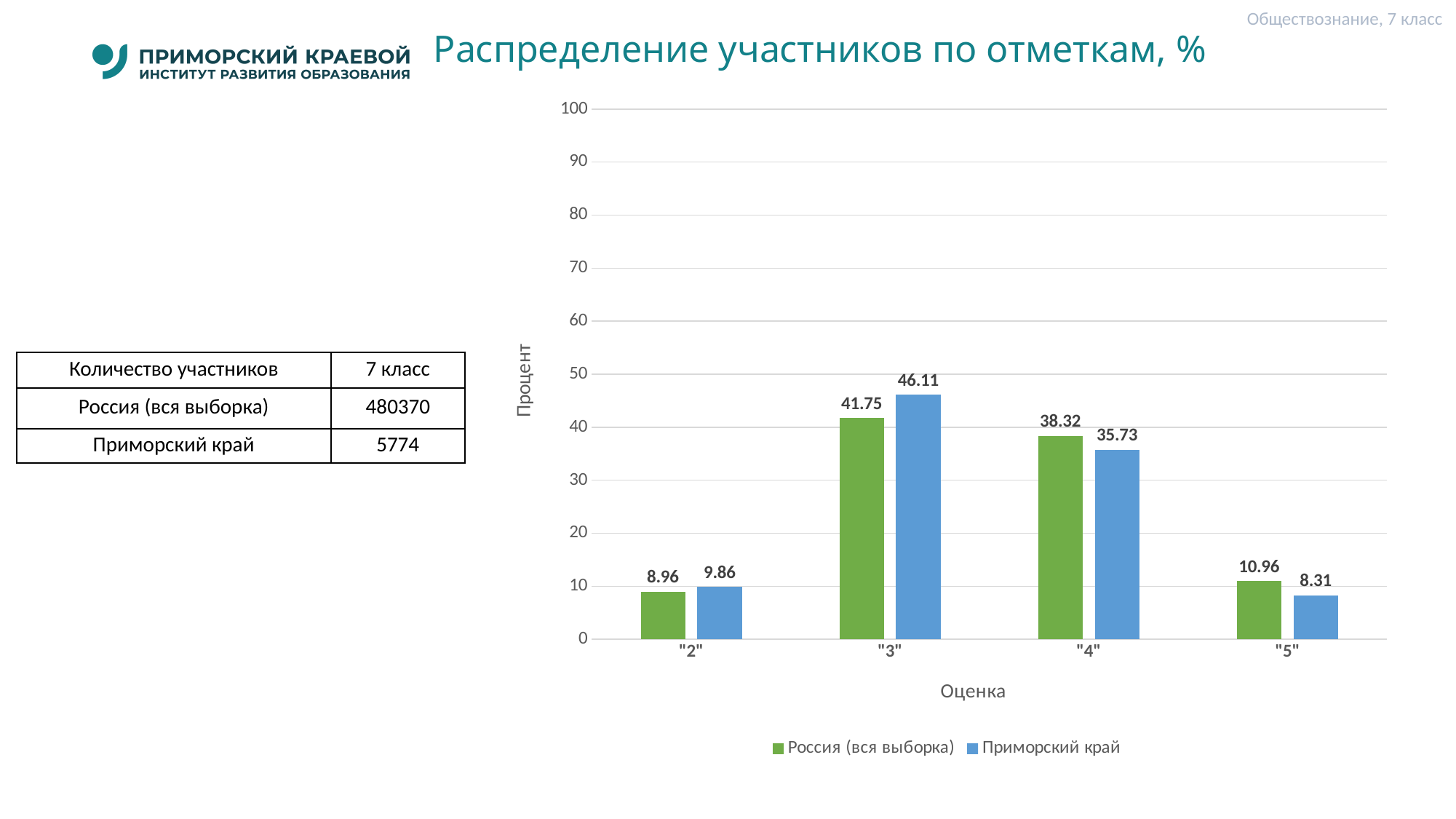
What is the value for Россия (вся выборка) at grade "3"? 41.75 How many grade categories are shown on the x axis? 4 Which grade has the highest value for Приморский край? "3" Which grade has the lowest value for Россия (вся выборка)? "2" Which is larger at grade "5": Россия (вся выборка) or Приморский край? Россия (вся выборка) What is the difference between Приморский край and Россия (вся выборка) at grade "3"? 4.36 What is the value for Приморский край at grade "2"? 9.86 What is the value for Приморский край at grade "4"? 35.73 How many series does the legend list? 2 Is the value for Россия (вся выборка) at grade "4" greater or less than 30? greater What kind of chart is shown on the slide? bar chart What is the label of the y axis? Процент